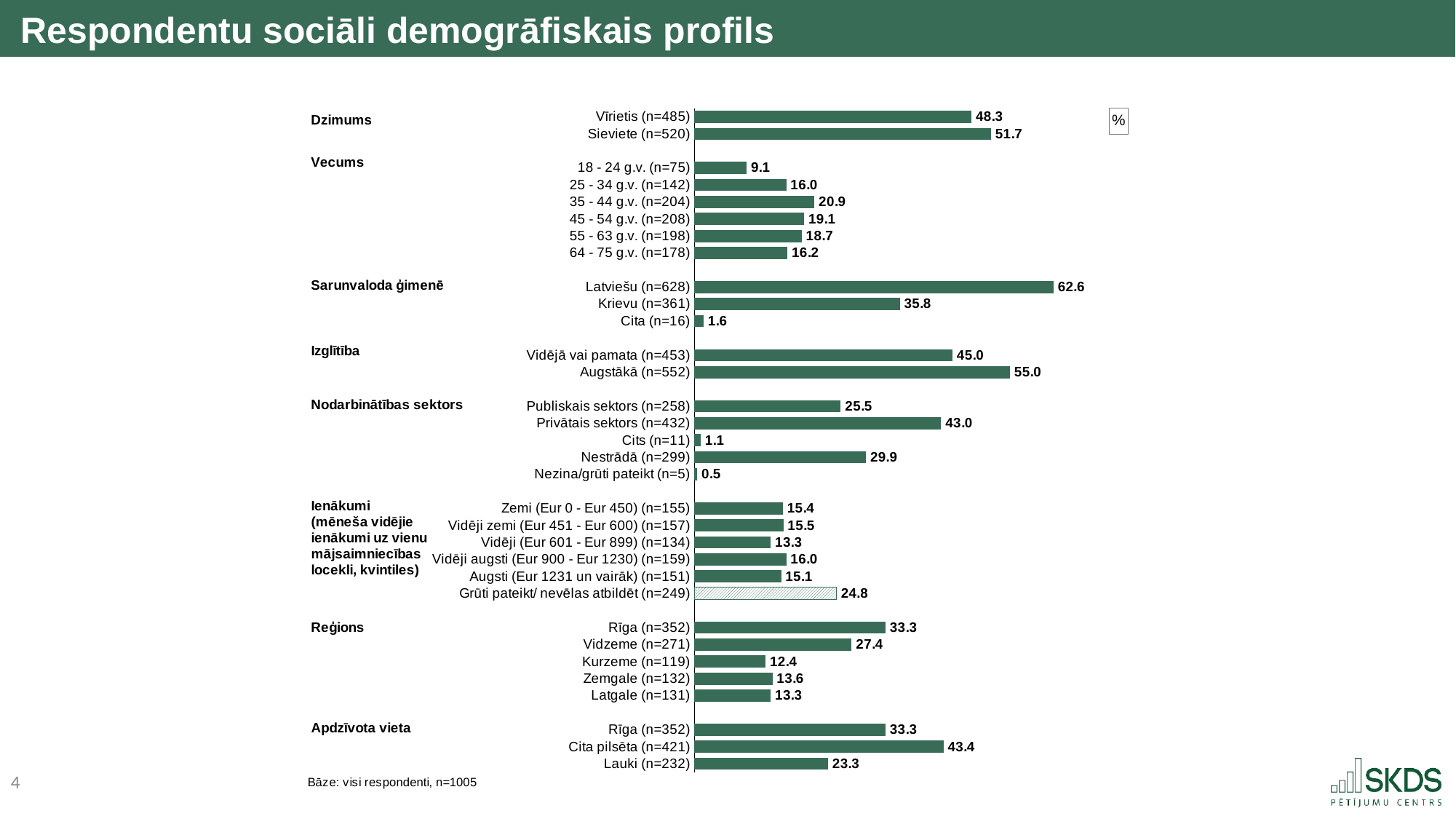
What kind of chart is shown on the slide? Bar chart How many age groups (Vecums) are shown on the chart? 6 Which category has the highest value on the chart? Latviešu (n=628) What is the value for Sieviete (n=520)? 51.7 Which is larger, the value for Publiskais sektors (n=258) or Privātais sektors (n=432)? Privātais sektors (n=432) What is the value for Latviešu (n=628)? 62.6 Among the Reģions categories, which has the highest value? Rīga (n=352) Which category's bar is drawn with a hatched pattern instead of solid fill? Grūti pateikt/ nevēlas atbildēt (n=249) What is the value for Lauki (n=232)? 23.3 What is the difference between the values for Sieviete (n=520) and Vīrietis (n=485)? 3.4 Which category has the lowest value on the chart? Nezina/grūti pateikt (n=5) What is the difference between the values for Augstākā (n=552) and Vidējā vai pamata (n=453)? 10.0